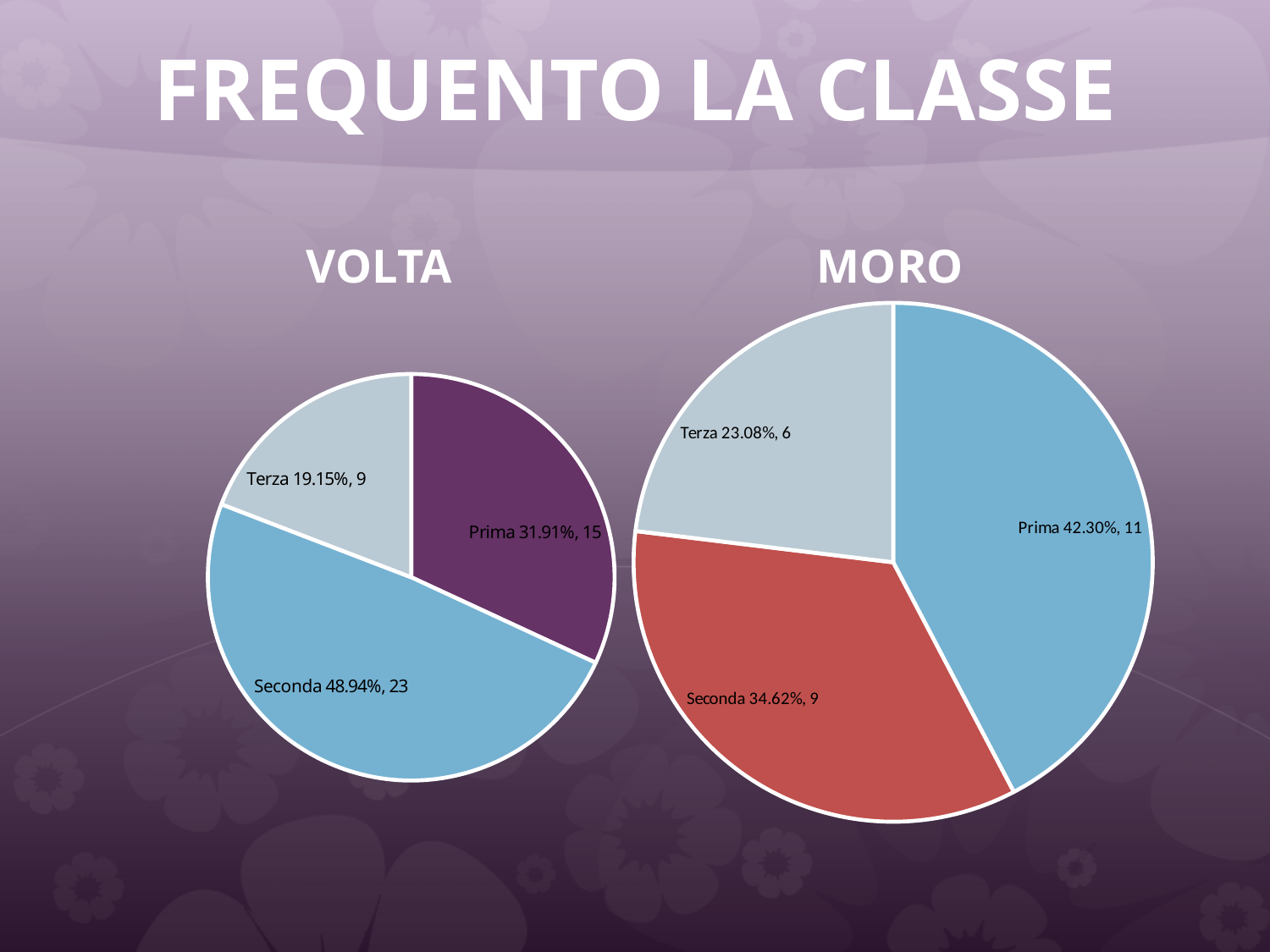
In the VOLTA chart, what is the total of all three slice values? 47 How many slices does the MORO chart have? 3 In the MORO chart, which category has the smallest slice? Terza In the VOLTA chart, which category has the largest slice? Seconda In the MORO chart, which is larger, Prima or Seconda? Prima In the VOLTA chart, what percentage share does Prima have? 31.91% In the MORO chart, what percentage share does Prima have? 42.30% In the MORO chart, what is the value for Terza? 6 What kind of chart is the VOLTA chart? Pie chart In the VOLTA chart, what is the difference between the values for Seconda and Terza? 14 What is the title of the slide? FREQUENTO LA CLASSE In the VOLTA chart, what is the value for Seconda? 23